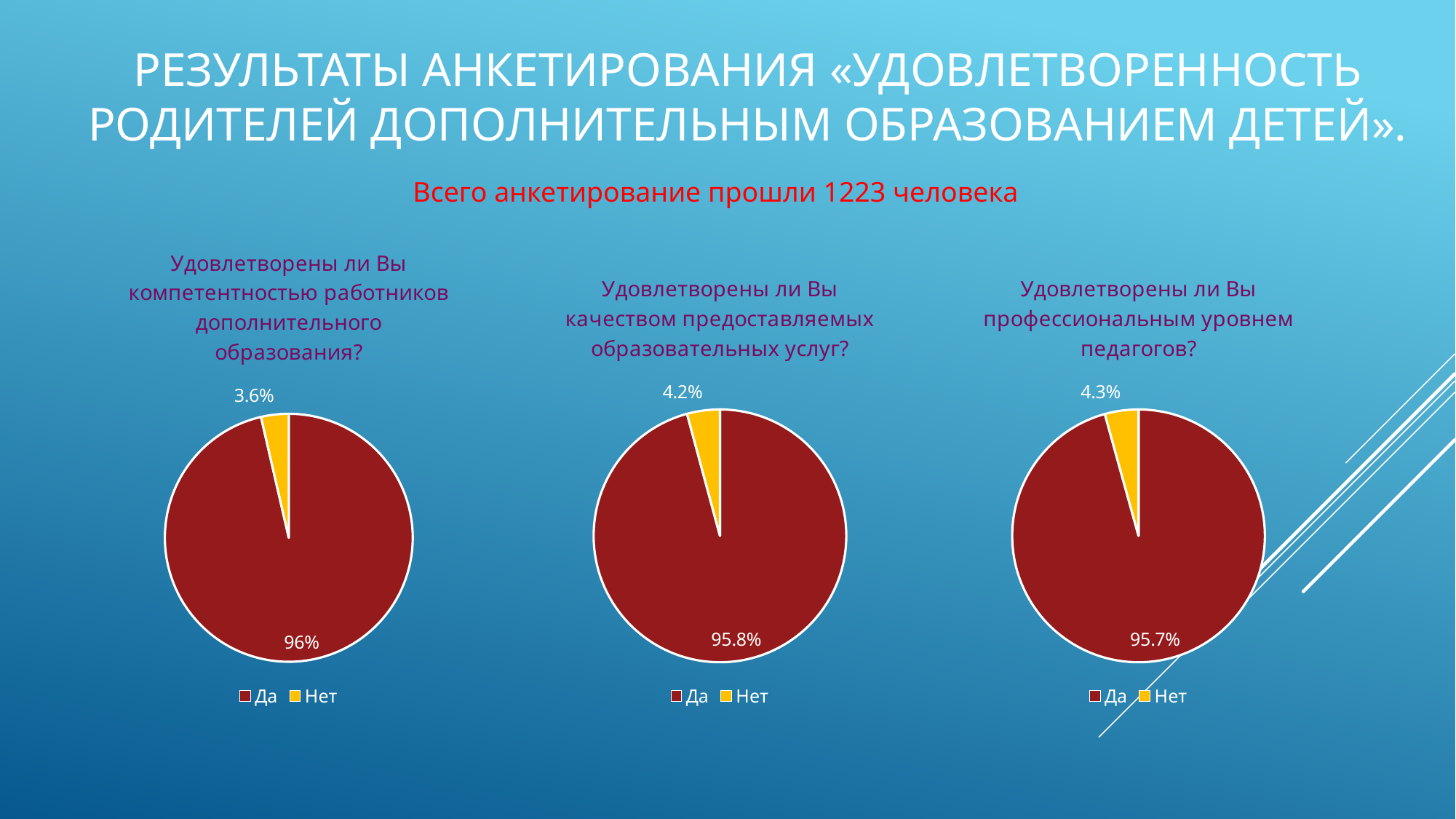
In the right pie chart (professional level of teachers), what share of respondents answered "Нет"? 4.3% How many entries does the legend of the left pie chart list? 2 In the middle pie chart (quality of educational services), what is the difference between the "Да" and "Нет" shares? 91.6% What kind of chart is used for each of the three charts on the slide? Pie chart How many slices does the middle pie chart (quality of educational services) have? 2 In the right pie chart (professional level of teachers), which slice is larger, "Да" or "Нет"? Да In the left pie chart (competence of additional education workers), what share of respondents answered "Да"? 96% What colour represents "Нет" in the pie charts? Yellow In the left pie chart (competence of additional education workers), what share of respondents answered "Нет"? 3.6% In the middle pie chart (quality of educational services), what share of respondents answered "Нет"? 4.2% In the right pie chart (professional level of teachers), what share of respondents answered "Да"? 95.7% In the middle pie chart (quality of educational services), what share of respondents answered "Да"? 95.8%